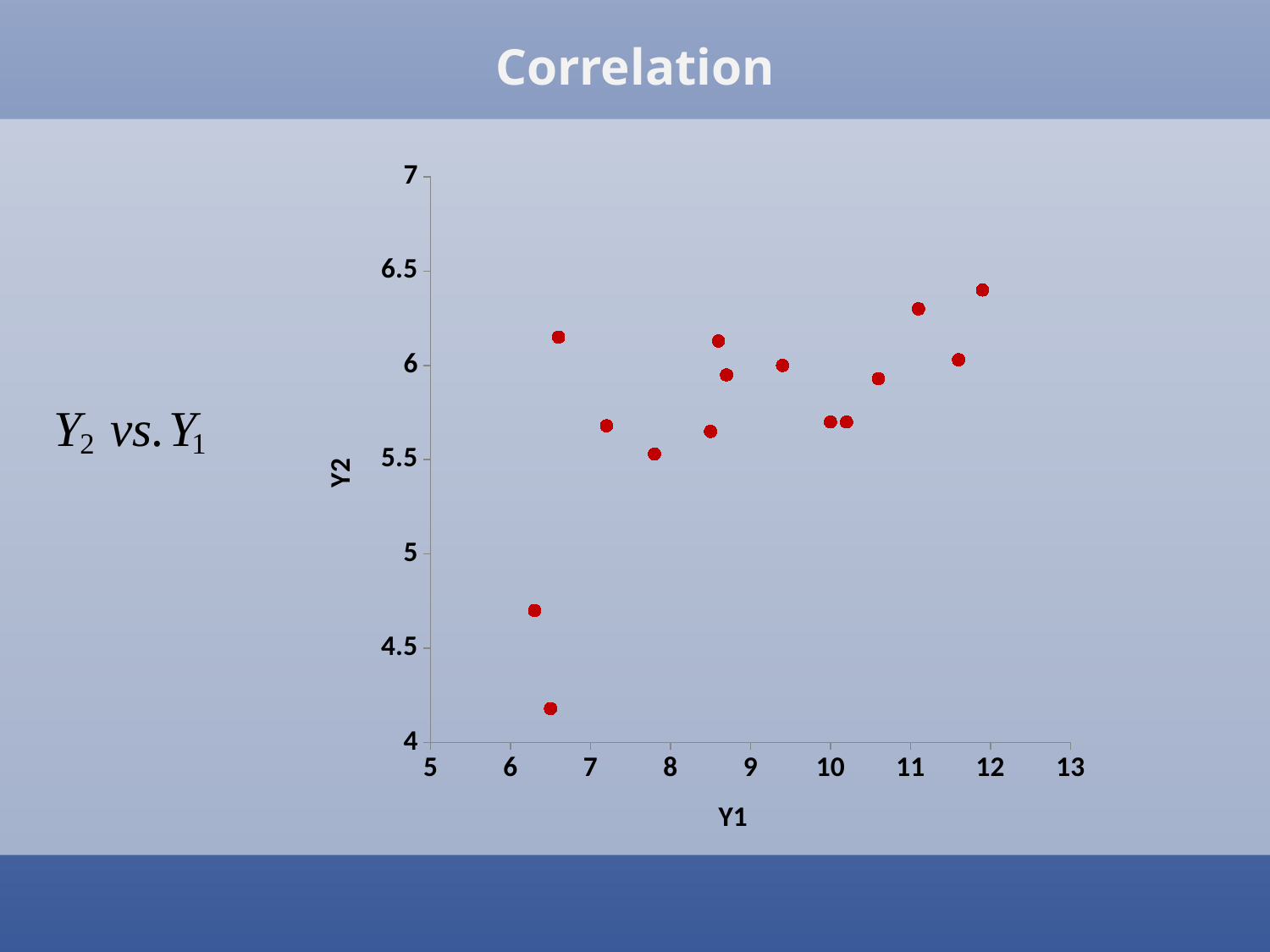
Is the Y2 value of the highest point on the chart greater or less than 6.5? less What is the label of the horizontal axis? Y1 What kind of chart is shown on the slide? Scatter plot Do the Y2 values generally rise or fall as Y1 increases? Rise How many data points are plotted in the scatter chart? 15 Which has the larger Y2 value: the point near Y1 = 11.9 or the point near Y1 = 6.5? The point near Y1 = 11.9 What is the label of the vertical axis? Y2 What is the highest tick value shown on the Y2 axis? 7 Is the Y2 value of the lowest point on the chart greater or less than 4.5? less Is the Y2 value of the point with the largest Y1 greater or less than 6? greater